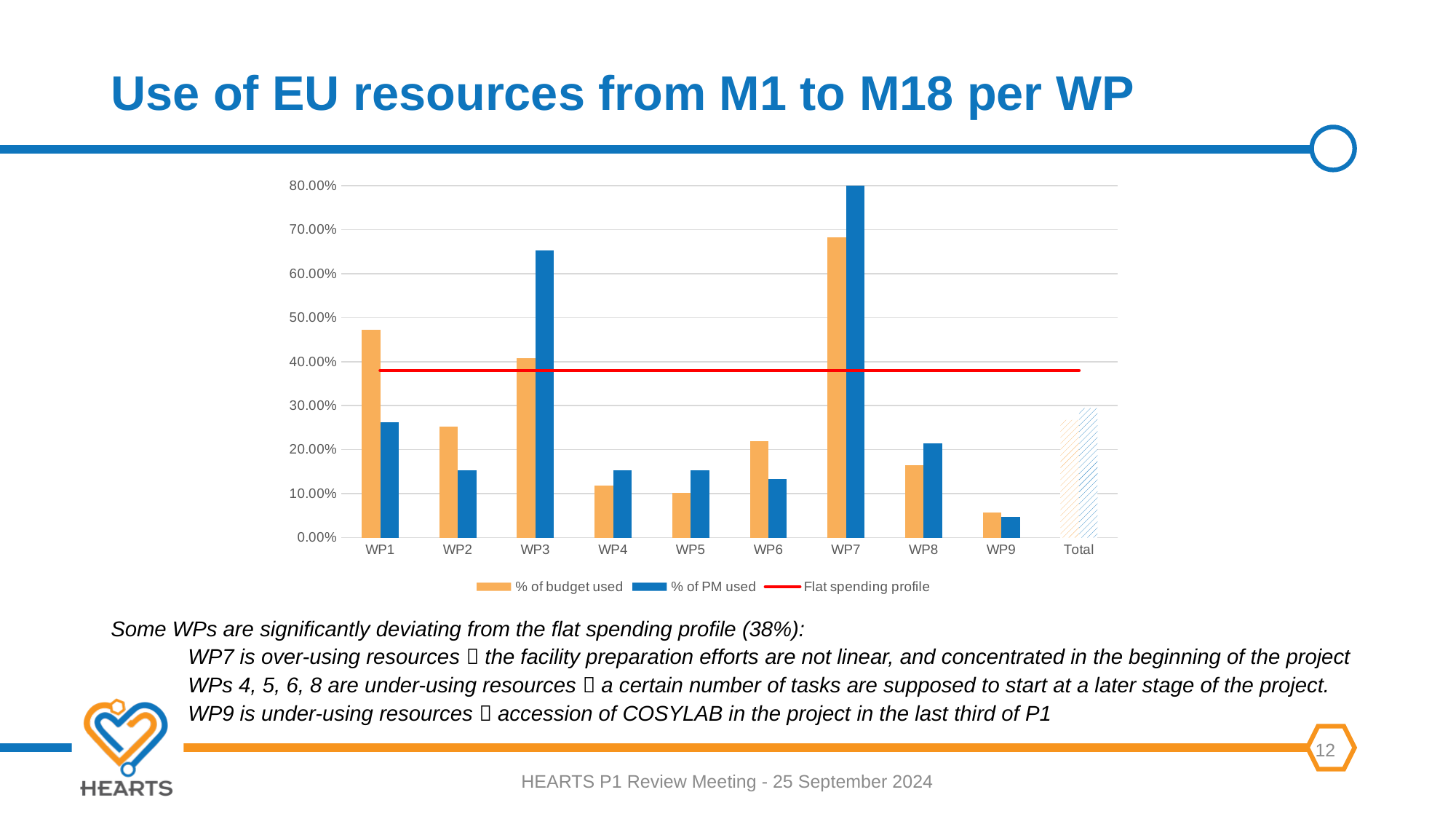
How many categories are shown on the x axis? 10 What colour are the bars for % of PM used? blue For WP3, which is larger: % of budget used or % of PM used? % of PM used What kind of chart is shown on the slide? bar and line chart For WP1, which is larger: % of budget used or % of PM used? % of budget used Which WP has the lowest value for % of budget used? WP9 How many series does the legend list? 3 Which WP has the highest value for % of budget used? WP7 Is the value of % of budget used for WP7 greater or less than 70.00%? less Which WP has the highest value for % of PM used? WP7 Is the value of % of PM used for WP3 greater or less than 60.00%? greater Is the value of % of budget used for WP1 greater or less than 40.00%? greater